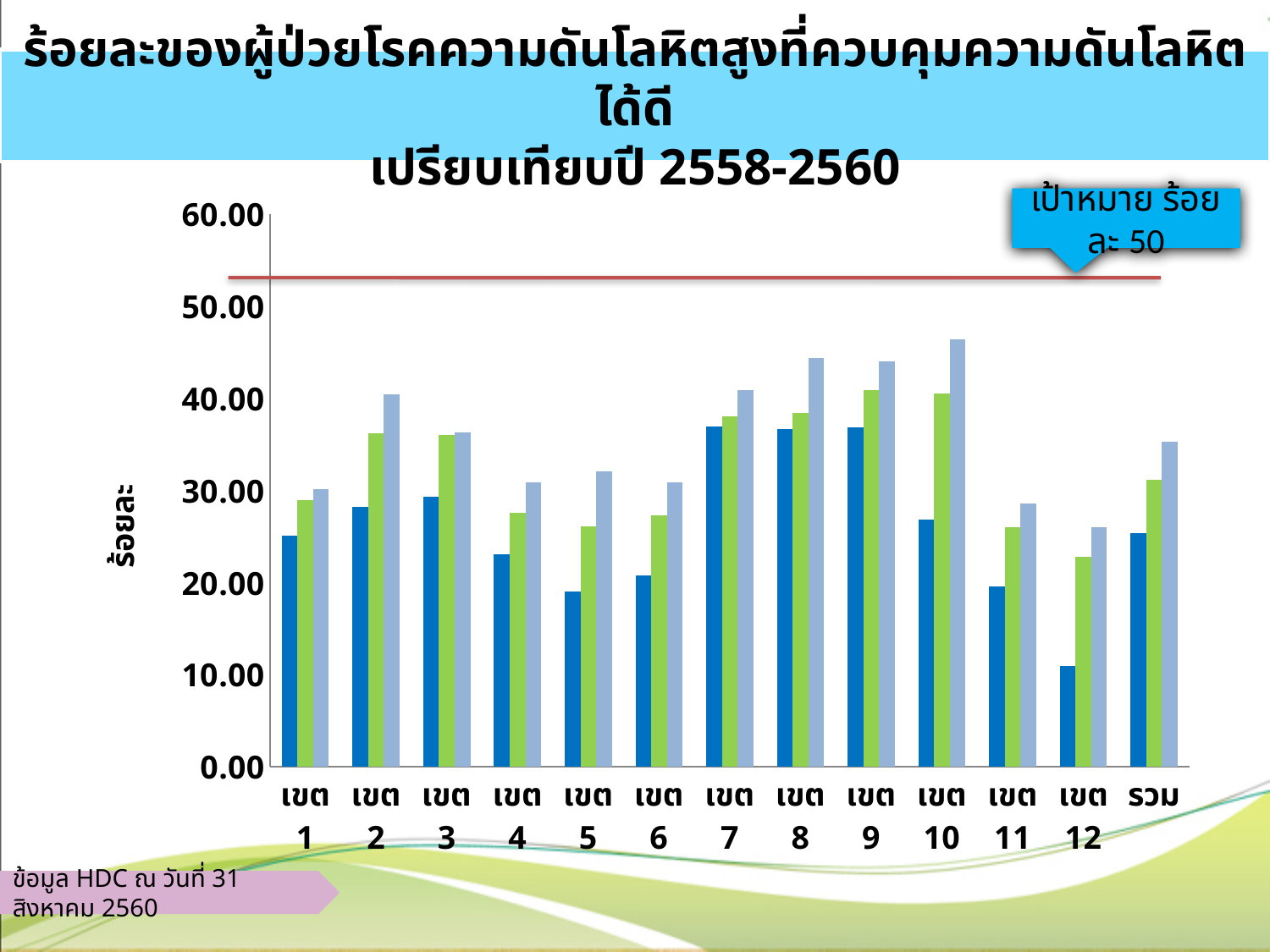
Which category contains the tallest bar on the chart? เขต 10 What target value does the callout box on the chart state? เป้าหมาย ร้อยละ 50 Is the value of the first (dark blue) bar for เขต 1 greater or less than 20.00? greater Is the value of the third (light blue) bar for เขต 10 greater or less than 40.00? greater Which is larger: the first (dark blue) bar for เขต 7 or the first (dark blue) bar for เขต 4? เขต 7 Which category contains the shortest bar on the chart? เขต 12 Is the value of the first (dark blue) bar for เขต 12 greater or less than 20.00? less How many categories are shown along the x axis of the chart? 13 How many bars are plotted for each category on the chart? 3 What kind of chart is shown on the slide? bar chart Within เขต 12, do the three bars increase or decrease from left to right? increase